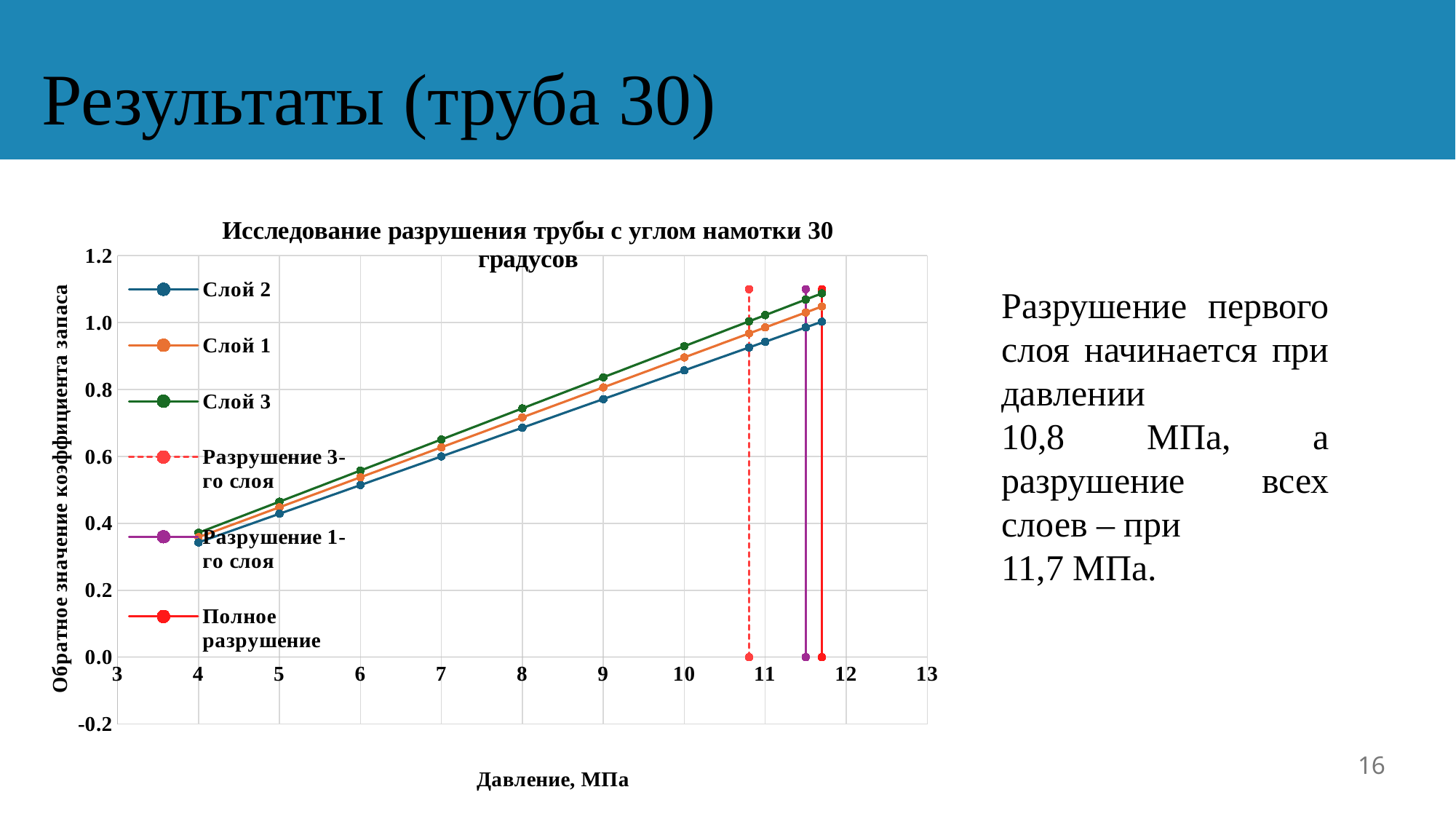
Which series has the highest values across the plotted pressure range: Слой 1, Слой 2 or Слой 3? Слой 3 Which series has the lowest values across the plotted pressure range: Слой 1, Слой 2 or Слой 3? Слой 2 How many series does the legend of the chart list? 6 What is the title of the chart? Исследование разрушения трубы с углом намотки 30 градусов Is the vertical line for Разрушение 3-го слоя located at a pressure greater or less than 11 МПа? less At a pressure of 8 МПа, which is larger: the value for Слой 3 or the value for Слой 2? Слой 3 What kind of chart is shown on the slide? Line chart What is the label of the x axis of the chart? Давление, МПа Do the values for Слой 2 rise or fall as pressure increases along the x axis? Rise Is the value for Слой 3 at a pressure of 6 МПа greater or less than 0.6? less Is the value for Слой 2 at a pressure of 4 МПа greater or less than 0.4? less